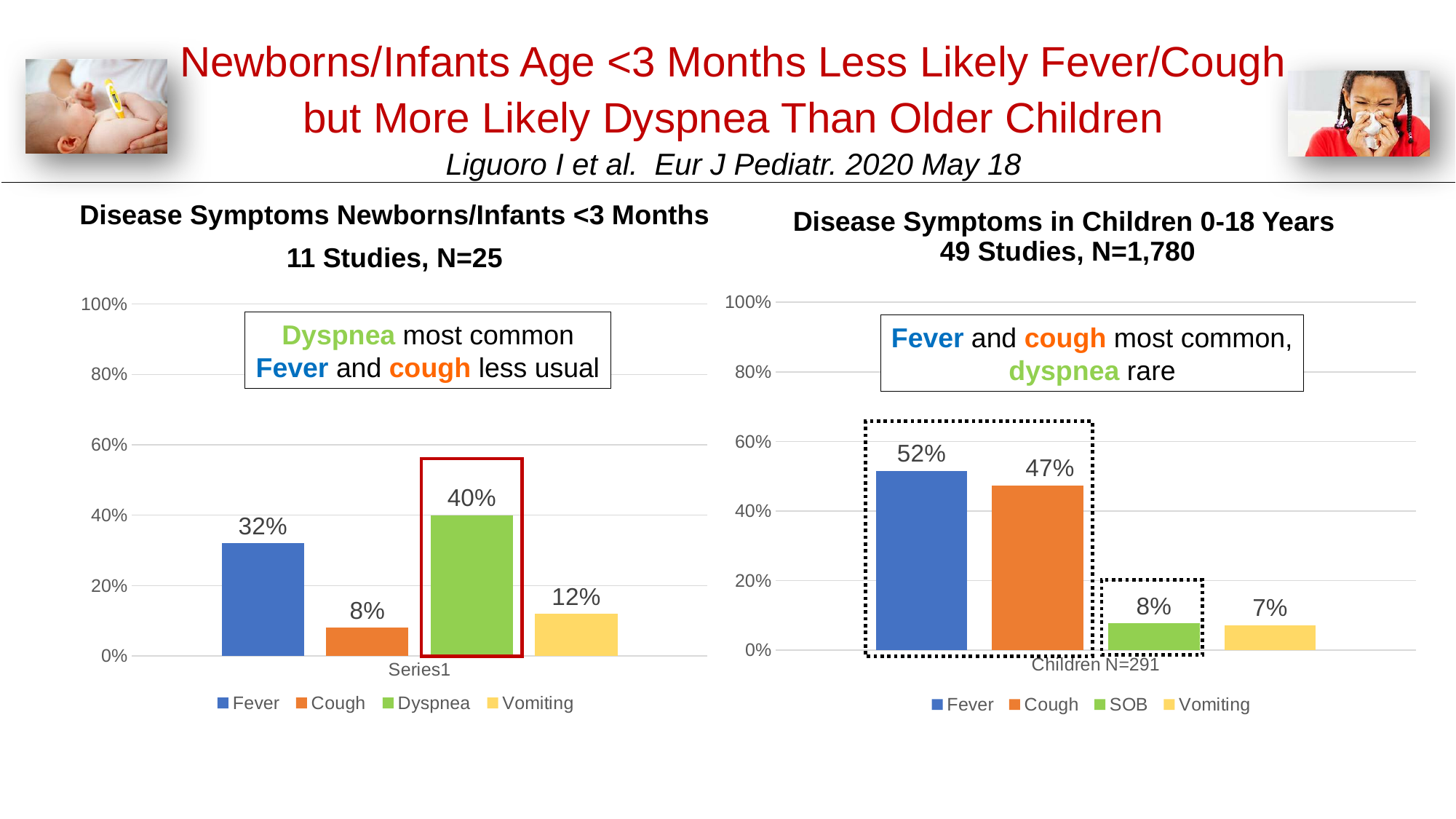
In the right chart (Disease Symptoms in Children 0-18 Years), what is the difference between the Fever and Cough values? 5% In the right chart (Disease Symptoms in Children 0-18 Years), what is the value for Fever? 52% In the left chart (Disease Symptoms Newborns/Infants <3 Months), what is the value for Dyspnea? 40% In the right chart (Disease Symptoms in Children 0-18 Years), which symptom has the lowest value? Vomiting In the left chart (Disease Symptoms Newborns/Infants <3 Months), what is the value for Cough? 8% In the right chart (Disease Symptoms in Children 0-18 Years), what is the value for SOB? 8% In the left chart (Disease Symptoms Newborns/Infants <3 Months), which symptom has the lowest value? Cough What kind of chart is the left chart (Disease Symptoms Newborns/Infants <3 Months)? Bar chart How many series does the legend of the right chart (Disease Symptoms in Children 0-18 Years) list? 4 In the left chart (Disease Symptoms Newborns/Infants <3 Months), which symptom has the highest value? Dyspnea In the left chart (Disease Symptoms Newborns/Infants <3 Months), what is the difference between the Fever and Vomiting values? 20% Which is larger: Fever in the left chart (Newborns/Infants <3 Months) or Fever in the right chart (Children 0-18 Years)? Fever in the right chart (Children 0-18 Years)